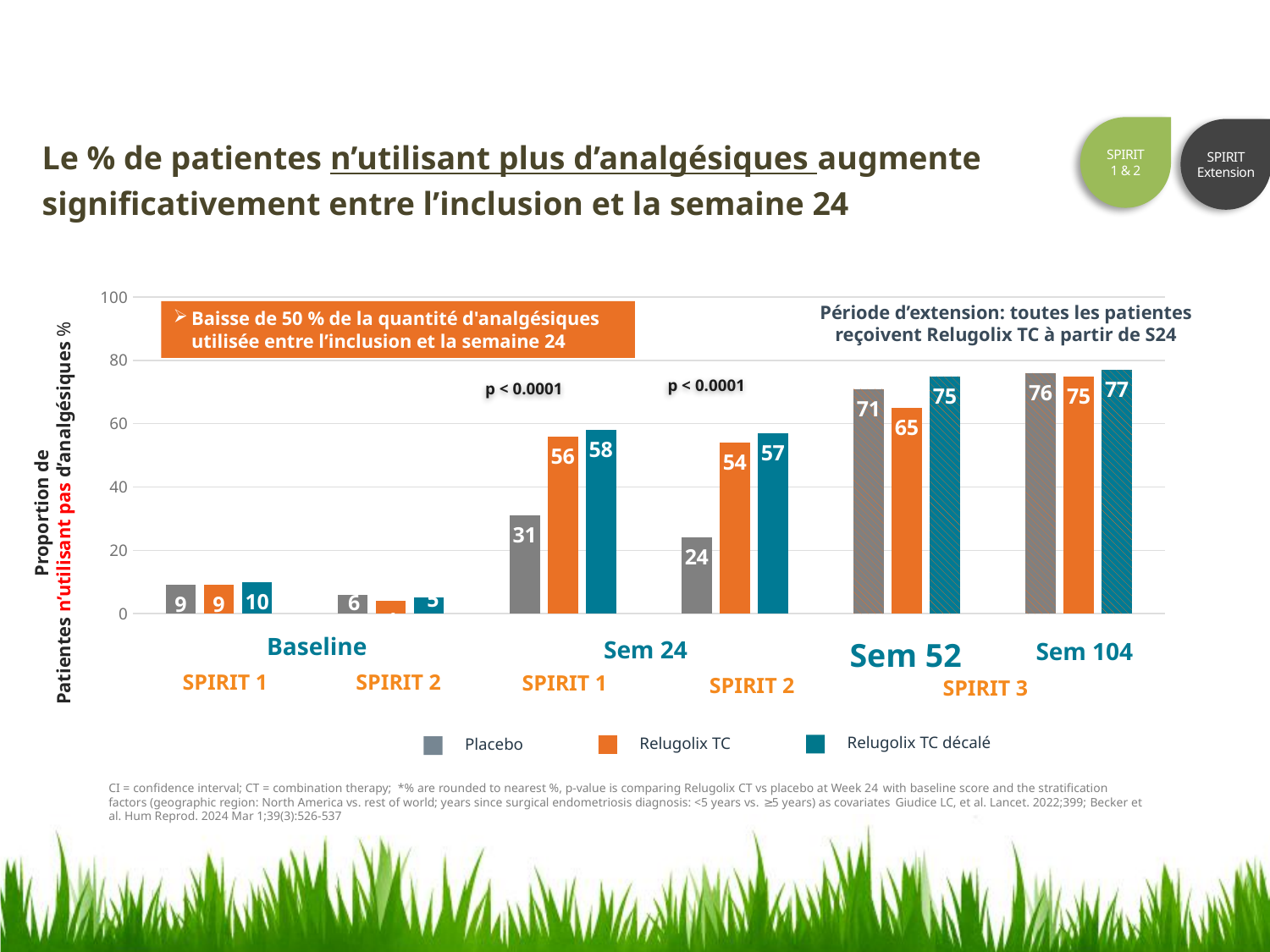
What is the value for Relugolix TC décalé in the Sem 104 SPIRIT 3 group? 77 Which series has the highest value in the Sem 52 SPIRIT 3 group? Relugolix TC décalé Which is larger in the Sem 24 SPIRIT 2 group: the Placebo value or the Relugolix TC décalé value? Relugolix TC décalé What is the value for Placebo in the Sem 52 SPIRIT 3 group? 71 Does the Placebo value rise or fall from Baseline SPIRIT 1 to Sem 24 SPIRIT 1? rise What is the value for Placebo in the Sem 24 SPIRIT 1 group? 31 Which series has the lowest value in the Sem 24 SPIRIT 1 group? Placebo Is the Placebo value in the Sem 104 SPIRIT 3 group greater or less than 60? greater What kind of chart is shown on the slide? bar chart What is the value for Relugolix TC in the Sem 24 SPIRIT 2 group? 54 What is the difference between the Relugolix TC value and the Placebo value in the Sem 24 SPIRIT 1 group? 25 How many series does the legend list? 3